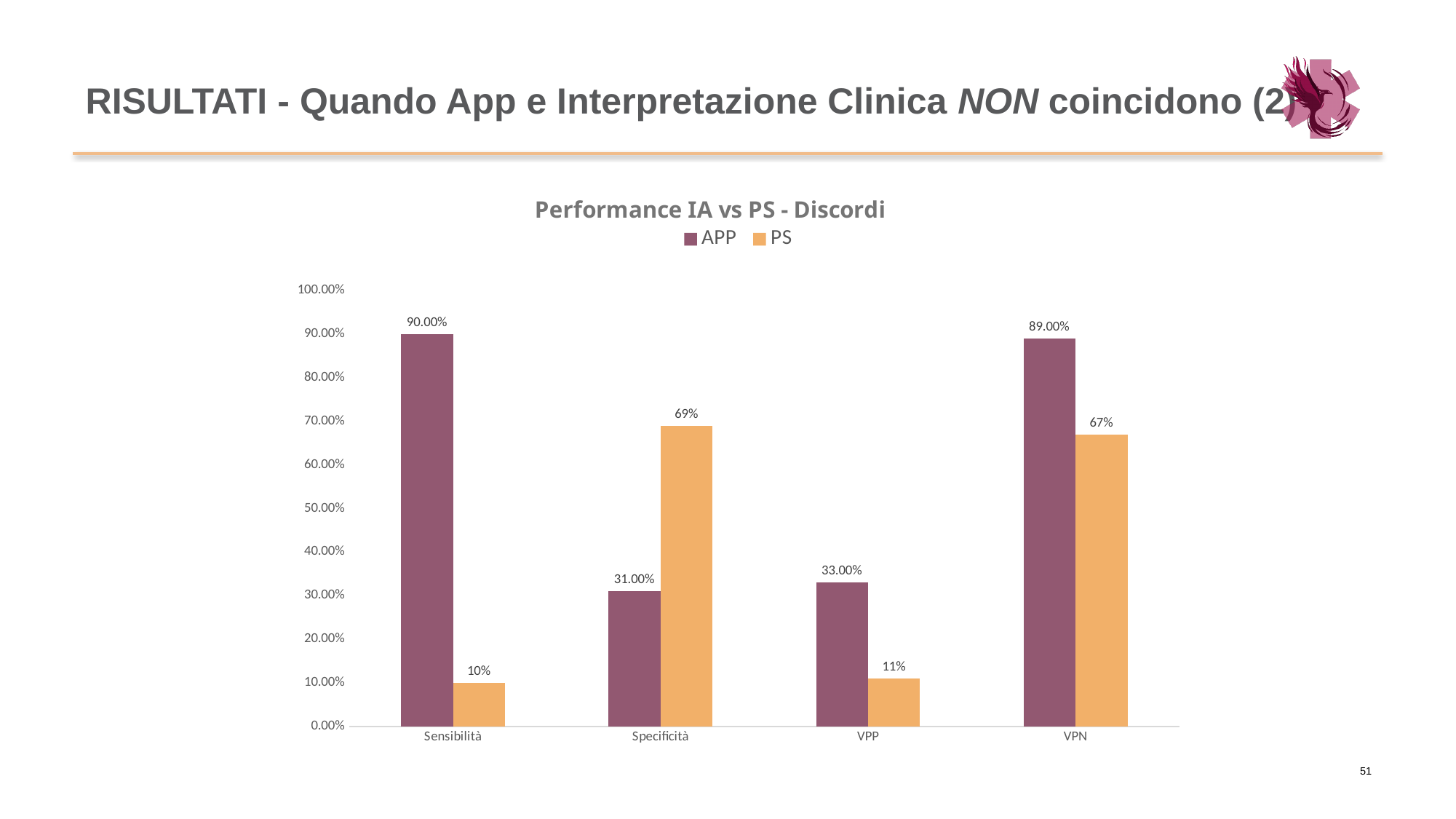
How many series does the legend list? 2 How many categories are shown on the x axis? 4 Which category has the lowest PS value? Sensibilità Which category has the highest APP value? Sensibilità What kind of chart is shown on the slide? Bar chart What is the PS value for Specificità? 69% What is the APP value for VPN? 89.00% What is the APP value for Sensibilità? 90.00% For Specificità, which series has the larger value, APP or PS? PS What is the title of the chart? Performance IA vs PS - Discordi What is the difference between the APP and PS values for Sensibilità? 80 percentage points What is the PS value for VPP? 11%